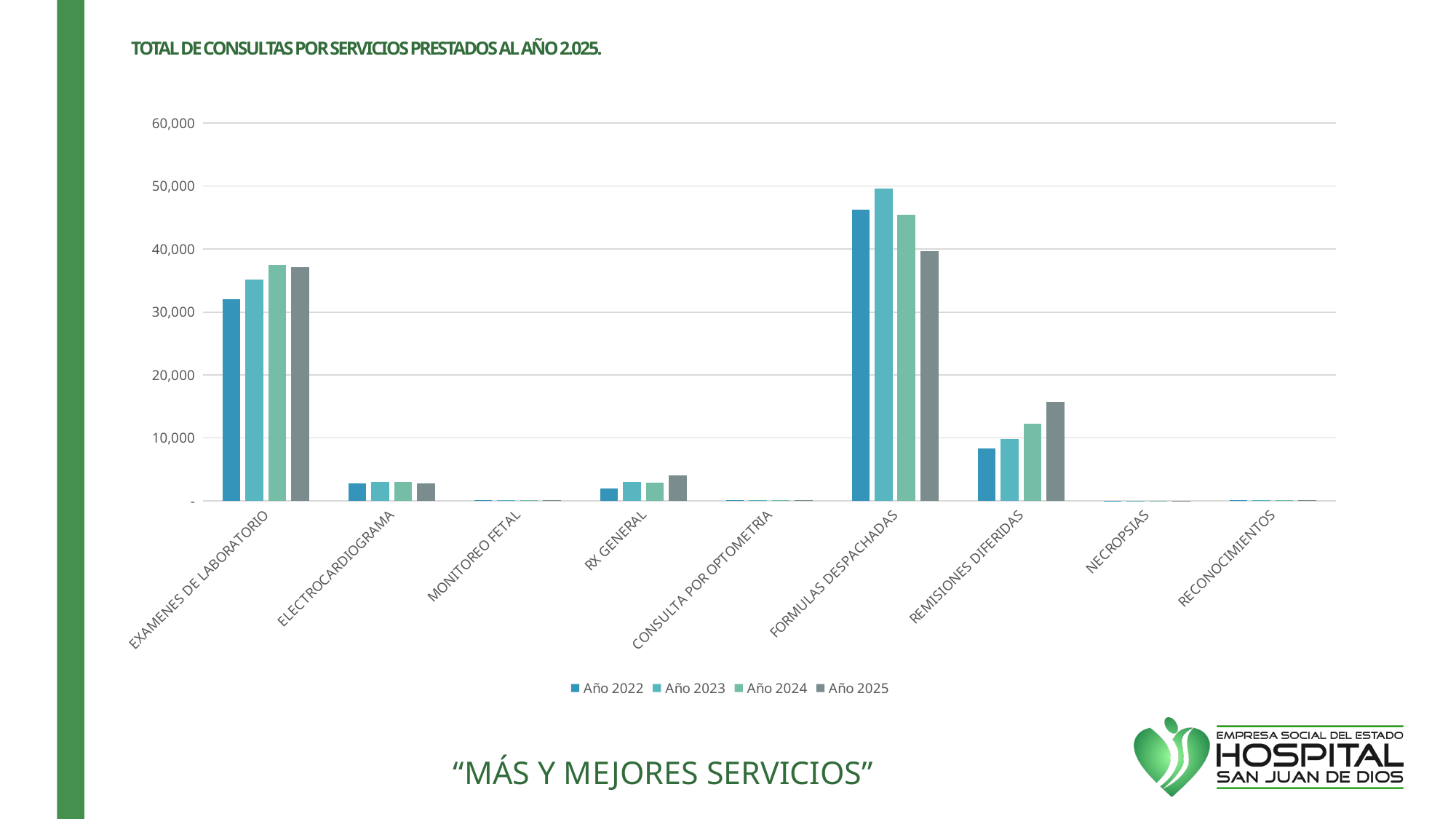
Do the values for REMISIONES DIFERIDAS rise or fall from Año 2022 to Año 2025? rise For FORMULAS DESPACHADAS, which is larger: the Año 2023 value or the Año 2025 value? Año 2023 What is the title of the chart? TOTAL DE CONSULTAS POR SERVICIOS PRESTADOS AL AÑO 2.025. How many series does the chart's legend list? 4 Is the Año 2022 value for EXAMENES DE LABORATORIO greater or less than 30,000? greater For EXAMENES DE LABORATORIO, which is larger: the Año 2022 value or the Año 2024 value? Año 2024 Which service category has the tallest bars in the chart? FORMULAS DESPACHADAS Is the Año 2023 value for FORMULAS DESPACHADAS greater or less than 40,000? greater What kind of chart is shown on the slide? Bar chart How many service categories are shown on the x axis of the chart? 9 Is the Año 2022 value for REMISIONES DIFERIDAS greater or less than 10,000? less